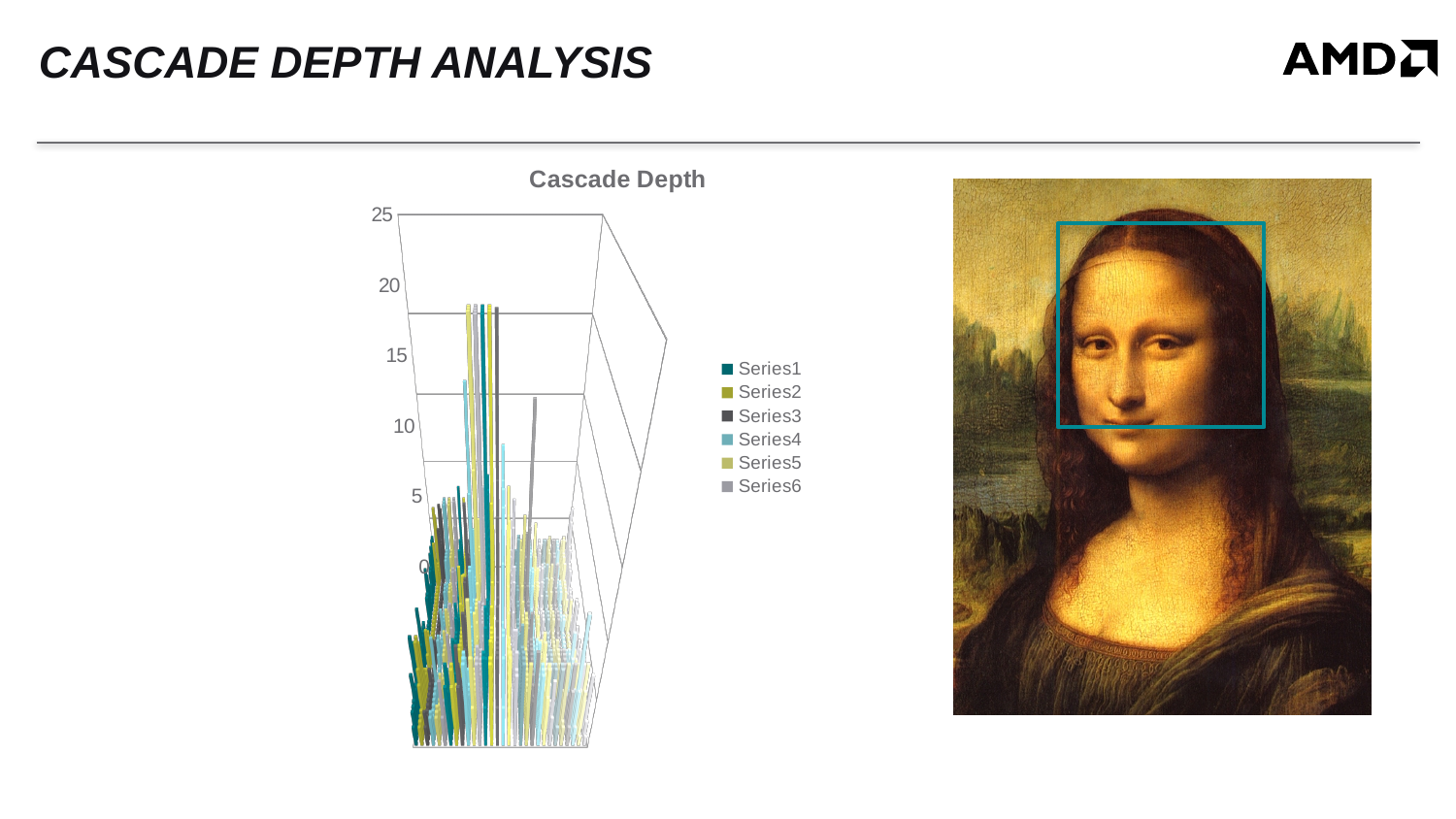
In the Cascade Depth chart, is the value of the tallest bar greater or less than 25? less What kind of chart is shown under the title "Cascade Depth"? bar chart In the Cascade Depth chart, is the value of the tallest bar greater or less than 10? greater How many series does the legend of the Cascade Depth chart list? 6 What is the title of the chart on the slide? Cascade Depth What is the last entry listed in the legend of the Cascade Depth chart? Series6